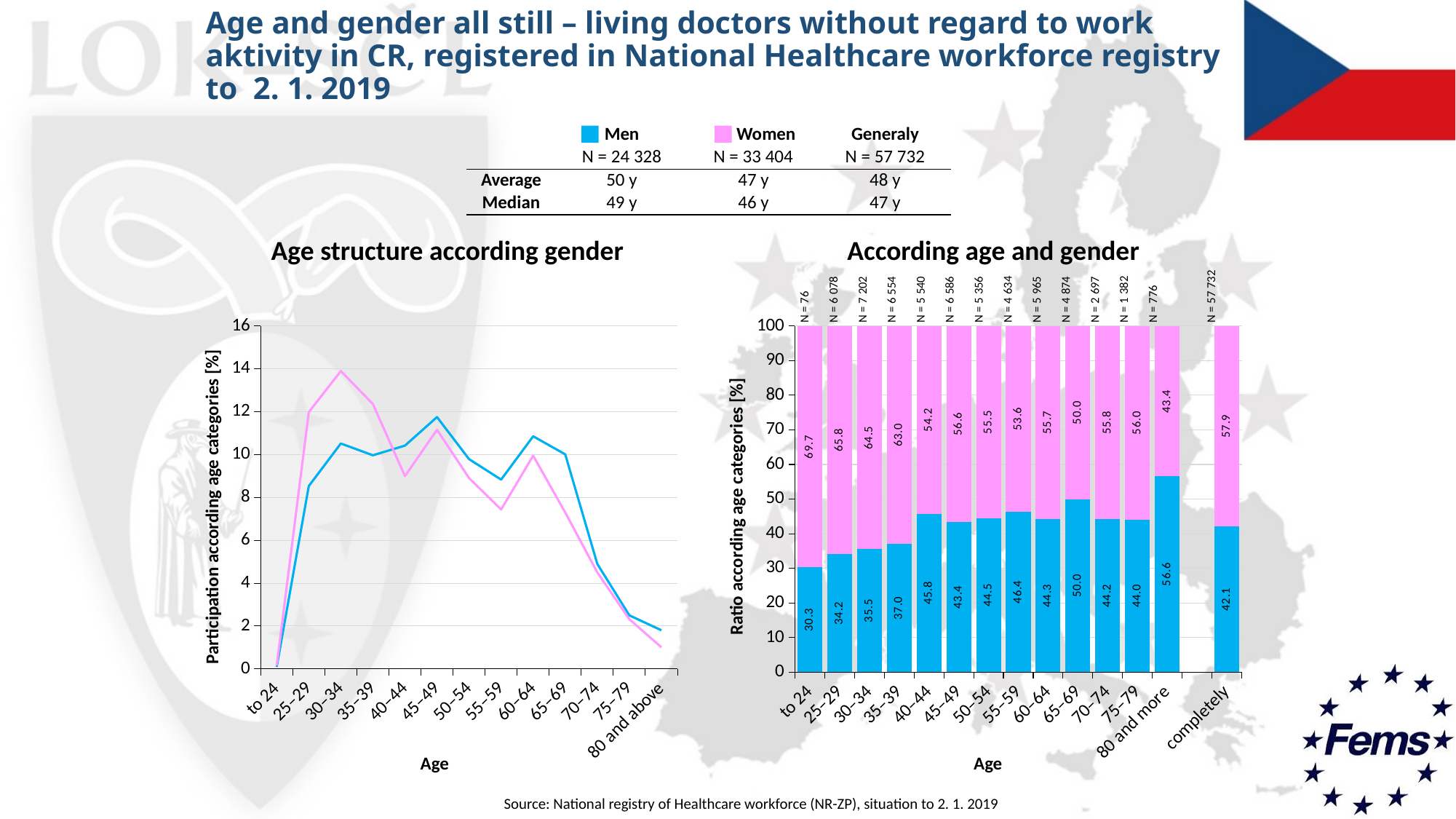
In the 'Age structure according gender' chart, is the Women value for 30–34 greater or less than 12? greater In the 'According age and gender' chart, what is the difference between the Women and Men values for the 35–39 age group? 26.0 In the 'According age and gender' chart, is the Men value larger for 55–59 or for 60–64? 55–59 What type of chart is 'Age structure according gender'? Line chart In the 'According age and gender' chart, what is the Men value for the 'completely' bar? 42.1 In the 'According age and gender' chart, what is the Men value for the 40–44 age group? 45.8 In the 'According age and gender' chart, which age group has the highest Men share? 80 and more In the 'According age and gender' chart, what is the Women value for the 'to 24' age group? 69.7 In the 'According age and gender' chart, which age group has the lowest Men share? to 24 In the 'According age and gender' chart, what is the N value shown above the 30–34 bar? N = 7 202 In the 'Age structure according gender' chart, is the Women value for 55–59 greater or less than 8? less